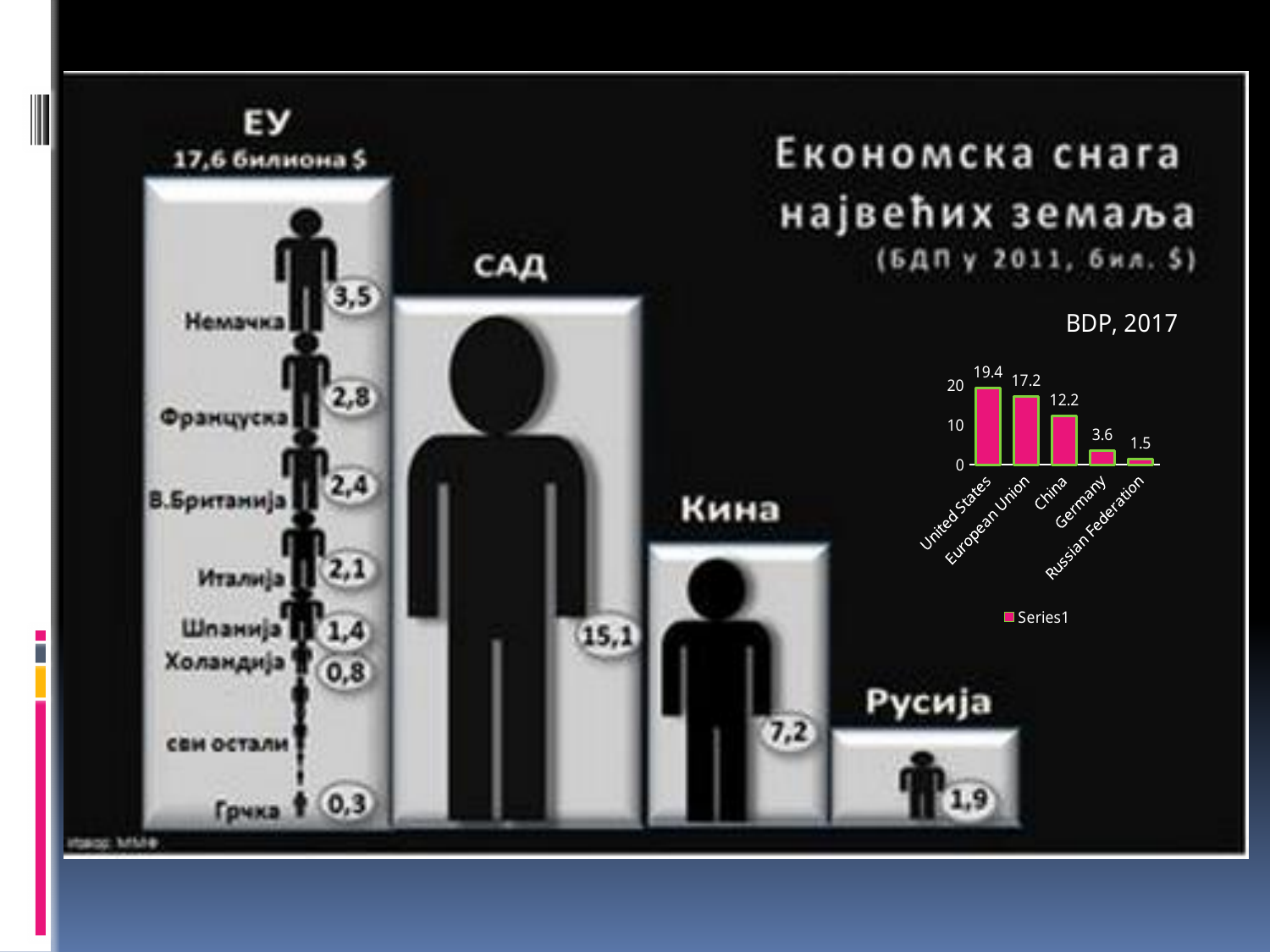
What kind of chart is the 'BDP, 2017' chart? bar chart In the 'BDP, 2017' chart, what is the difference between the values for United States and European Union? 2.2 In the 'BDP, 2017' chart, which category has the highest value? United States How many categories are shown in the 'BDP, 2017' chart? 5 In the 'BDP, 2017' chart, which category has the lowest value? Russian Federation In the 'BDP, 2017' chart, what is the value for Russian Federation? 1.5 In the 'BDP, 2017' chart, what is the value for United States? 19.4 How many series does the legend of the 'BDP, 2017' chart list? 1 In the 'BDP, 2017' chart, what is the value for Germany? 3.6 In the 'BDP, 2017' chart, is the value for European Union greater or less than 10? greater In the 'BDP, 2017' chart, which is larger, the value for China or the value for Germany? China In the 'BDP, 2017' chart, what is the value for China? 12.2